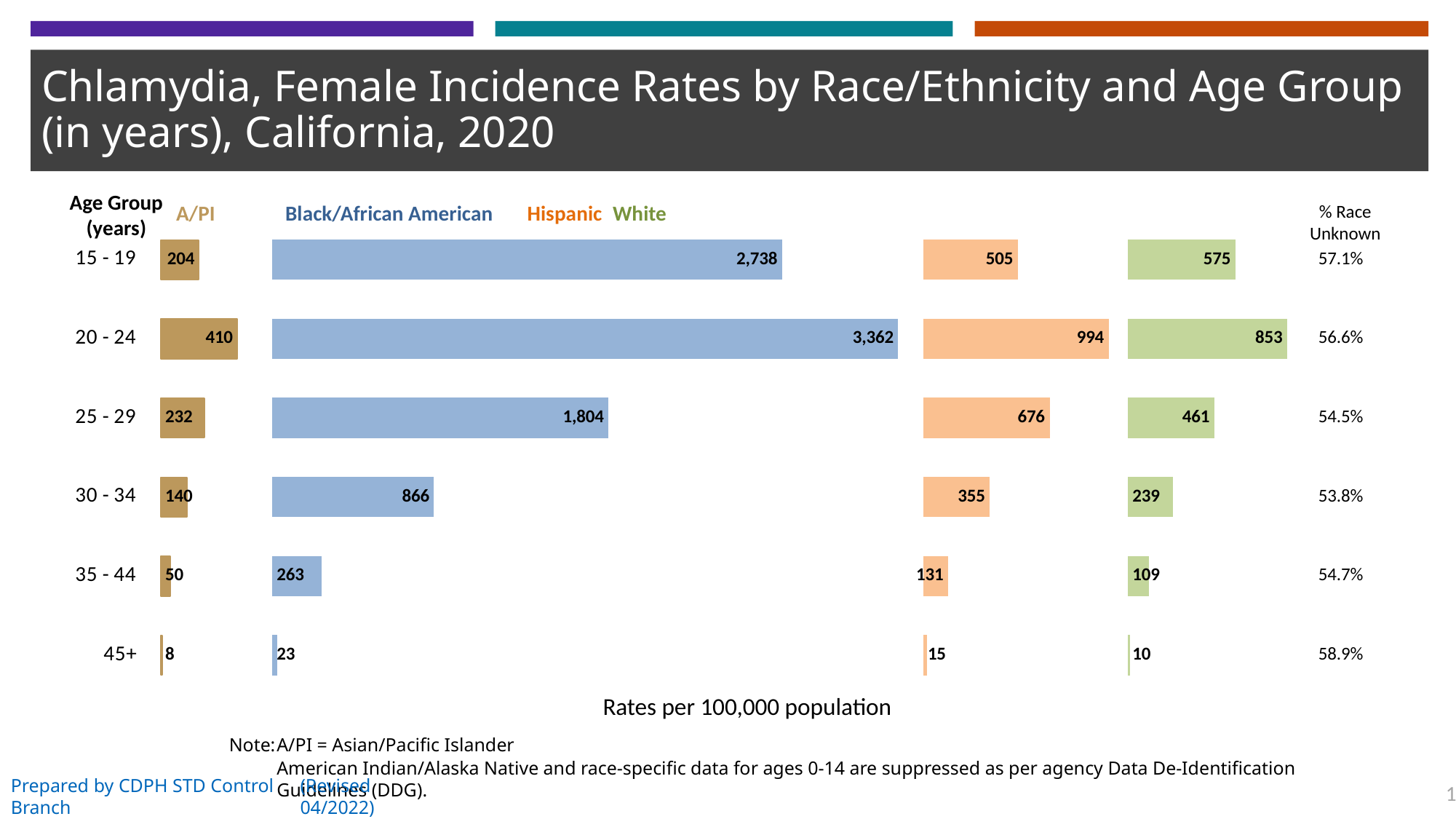
What is the rate for A/PI females aged 30 - 34? 140 What is the rate for White females aged 15 - 19? 575 How many age groups are shown in the chart? 6 What is the rate for Hispanic females aged 25 - 29? 676 What is the chlamydia incidence rate for Black/African American females aged 20 - 24? 3,362 Which age group has the lowest rate for Hispanic females? 45+ What type of chart is shown on the slide? Bar chart Which age group has the highest rate for Black/African American females? 20 - 24 What is the % Race Unknown value shown for the 45+ age group? 58.9% What is the difference between the Black/African American and White rates for ages 20 - 24? 2,509 Which is larger for ages 15 - 19: the Hispanic rate or the White rate? White How many race/ethnicity series does the chart show? 4